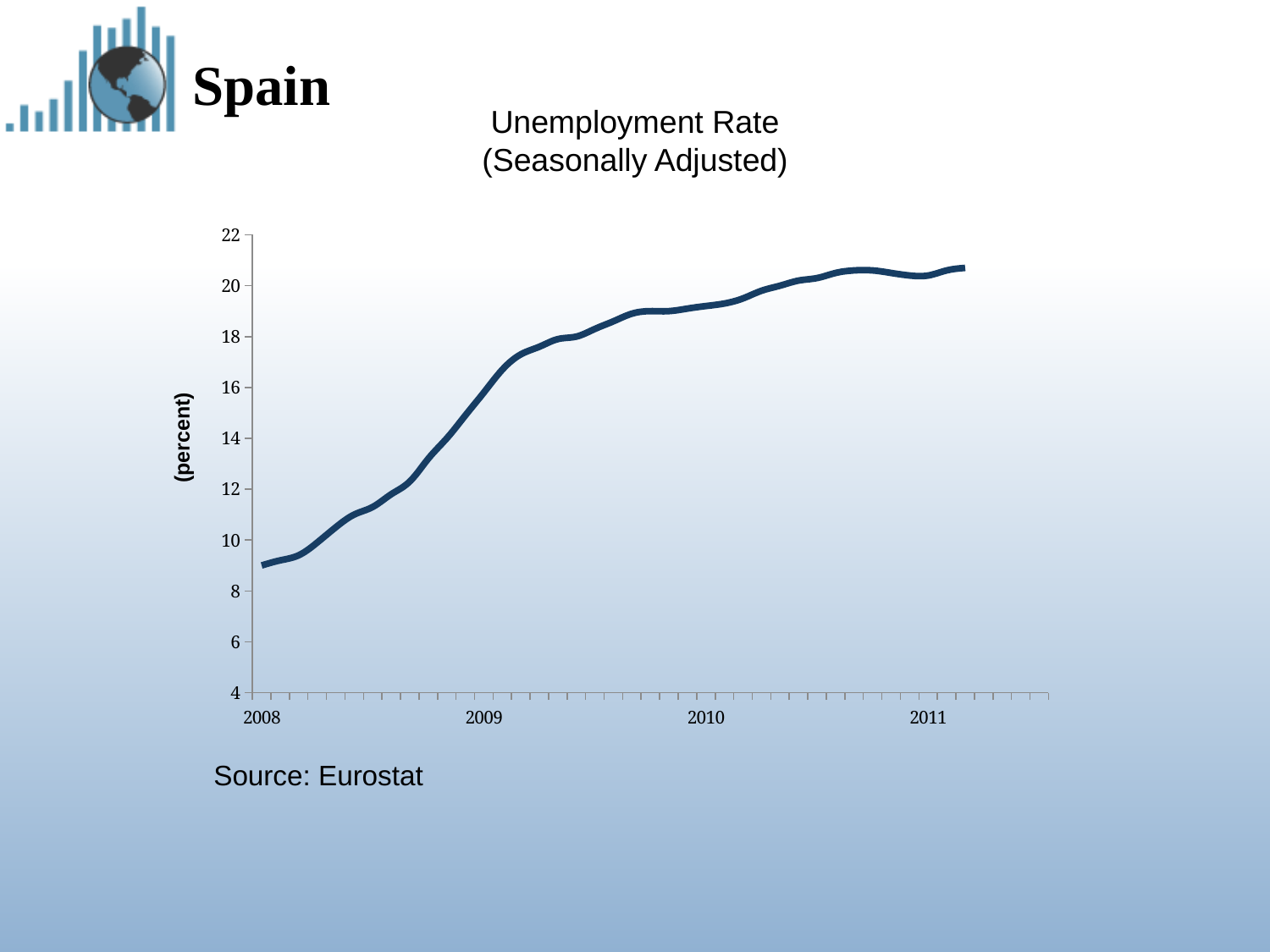
Is the unemployment rate at the start of 2011 greater or less than 20? greater How many years are labelled on the x axis? 4 Is the unemployment rate higher at the start of 2010 or at the start of 2009? 2010 What kind of chart is shown on the slide? line chart What is the title of the chart? Unemployment Rate (Seasonally Adjusted) Is the unemployment rate at the start of 2008 greater or less than 10? less At which labelled year on the x axis is the unemployment rate lowest? 2008 Is the unemployment rate at the start of 2010 greater or less than 18? greater What is the label on the vertical axis of the chart? (percent) Does the unemployment rate generally rise or fall from 2008 to 2011? rise